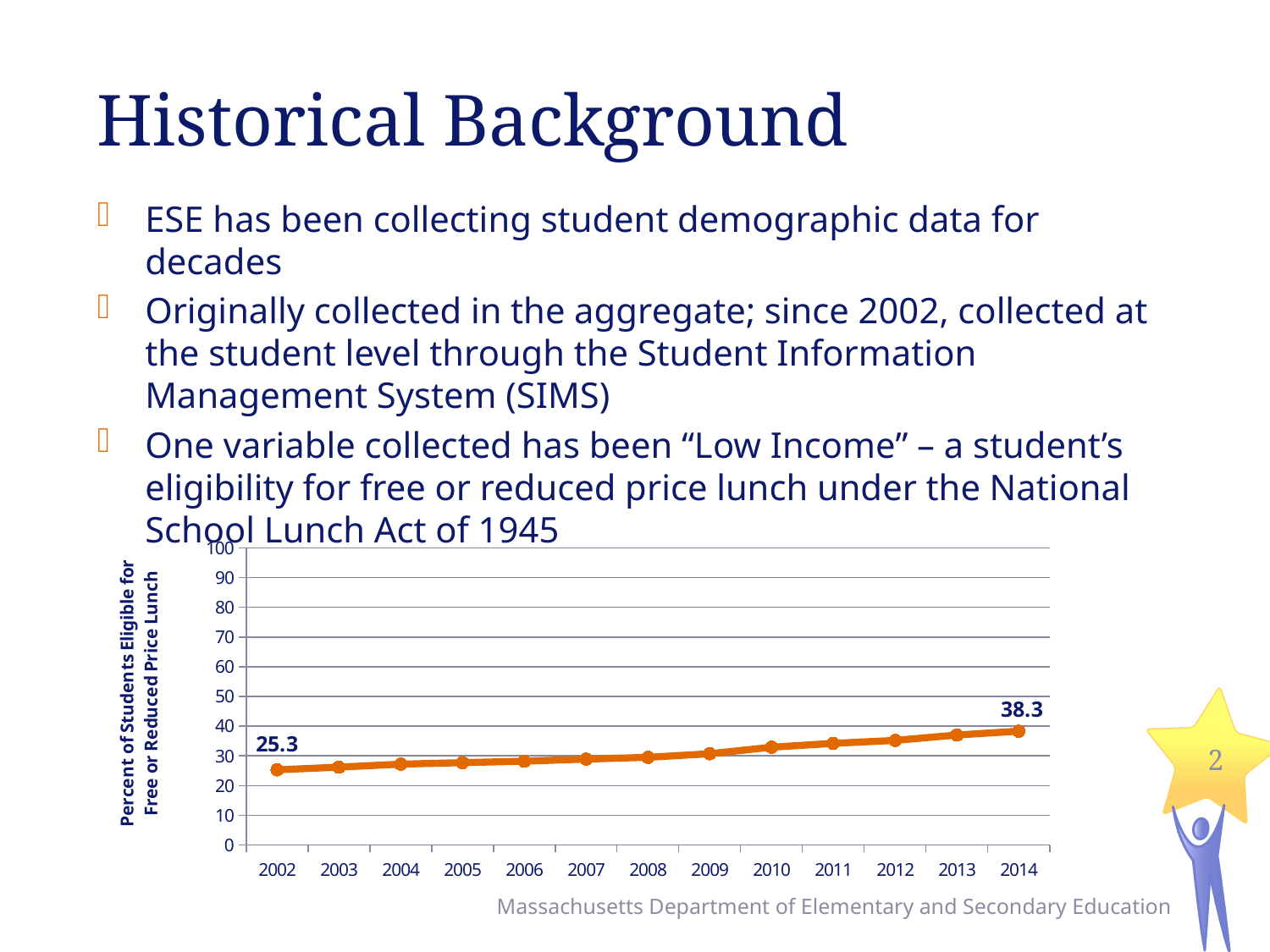
What is the difference between the values for 2014 and 2002? 13.0 Which year has the lowest value? 2002 Is the value for 2008 greater or less than 40? less What kind of chart is shown? line chart What is the label on the vertical axis? Percent of Students Eligible for Free or Reduced Price Lunch Is the value for 2012 greater or less than 30? greater What is the value for 2014? 38.3 Do the values rise or fall from 2002 to 2014? rise What is the value for 2002? 25.3 How many years are plotted on the x axis? 13 Which year has the highest value? 2014 Which is larger, the value for 2010 or the value for 2005? 2010